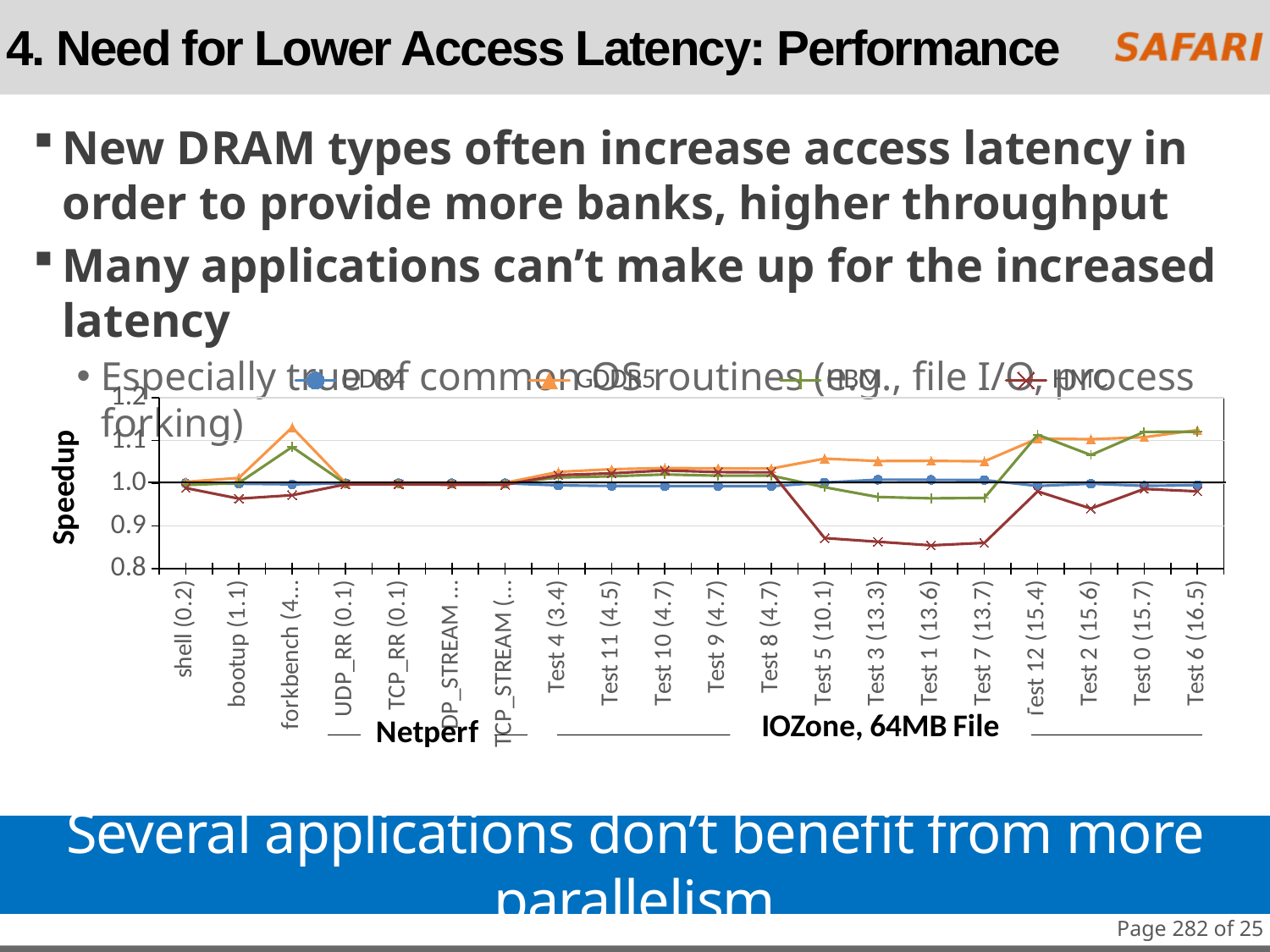
Is the GDDR5 value for forkbench greater or less than 1.1? greater How many series does the chart's legend list? 4 Which two benchmark groups are labelled beneath the x axis of the chart? Netperf and IOZone, 64MB File How many categories are plotted along the x axis of the chart? 20 What is the title of the y axis of the chart? Speedup Is the HBM value for Test 6 (16.5) greater or less than 1.1? greater What kind of chart is shown on the slide? line chart At forkbench, which series has the higher speedup, GDDR5 or HBM? GDDR5